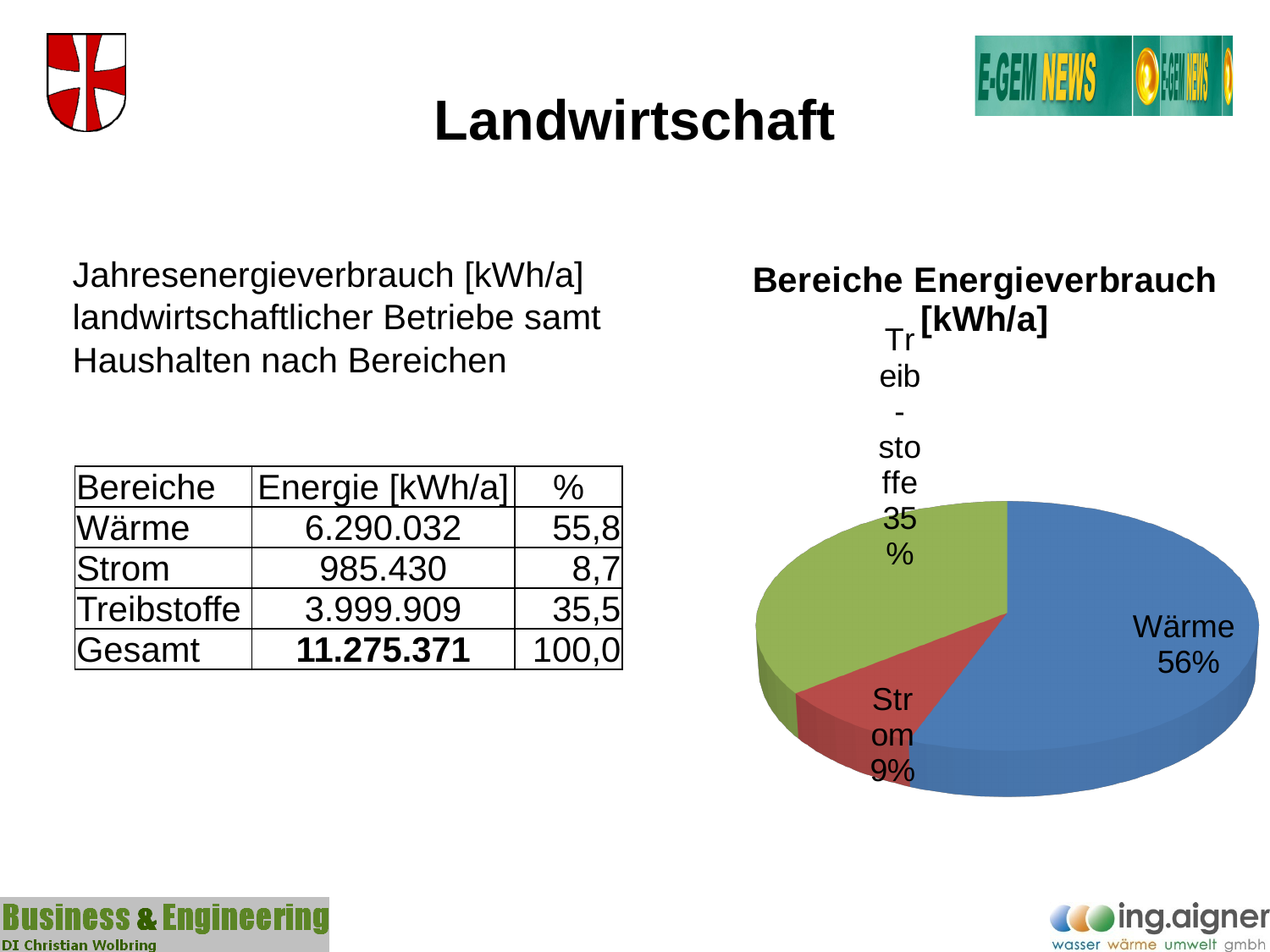
What share of the pie does Strom have? 9% What share of the pie does Treibstoffe have? 35% What is the difference in percentage points between the Wärme slice and the Treibstoffe slice? 21 What is the difference in percentage points between the Treibstoffe slice and the Strom slice? 26 What kind of chart is shown on the slide? pie chart Which slice is larger, Treibstoffe or Strom? Treibstoffe What is the title of the pie chart? Bereiche Energieverbrauch [kWh/a] How many slices does the pie chart have? 3 Which slice of the pie chart is the largest? Wärme What share of the pie does Wärme have? 56% What colour is the Wärme slice in the pie chart? blue Which slice of the pie chart is the smallest? Strom